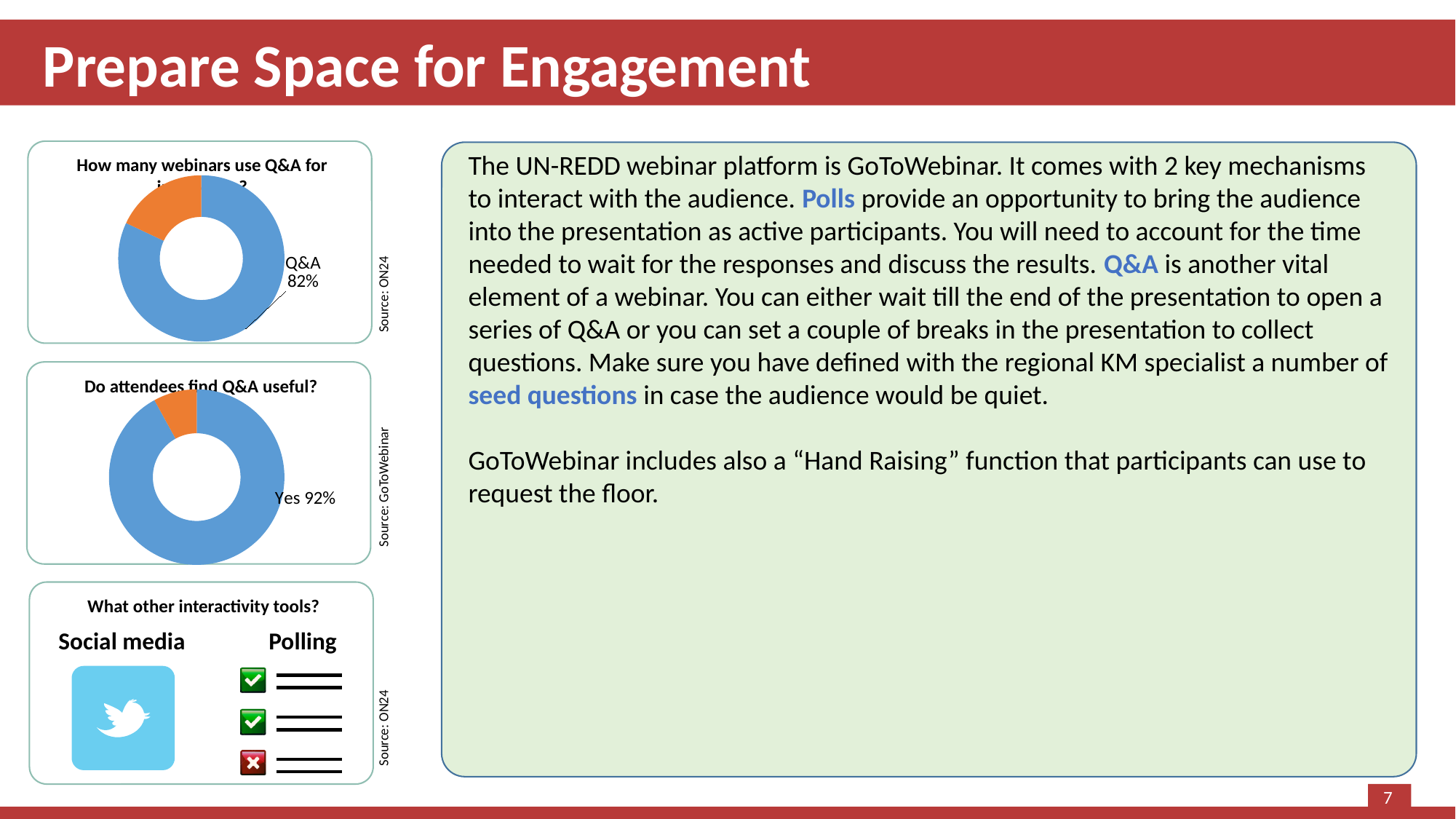
What kind of chart is the chart titled "Do attendees find Q&A useful?"? Doughnut chart In the top chart, which slice is larger, the blue slice or the orange slice? The blue slice What source is cited beside the chart titled "Do attendees find Q&A useful?"? GoToWebinar In the chart titled "Do attendees find Q&A useful?", which slice is smaller, the blue slice or the orange slice? The orange slice What kind of chart is the top chart on the left of the slide? Doughnut chart What colour is the Yes slice in the chart titled "Do attendees find Q&A useful?"? Blue In the top chart, what percentage is shown for the Q&A slice? 82% How many slices does the chart titled "Do attendees find Q&A useful?" have? 2 What is the difference between the Yes share (92%) in the middle chart and the Q&A share (82%) in the top chart? 10 percentage points In the chart titled "Do attendees find Q&A useful?", what percentage is shown for the Yes slice? 92% Which is larger: the Q&A share in the top chart or the Yes share in the chart titled "Do attendees find Q&A useful?"? The Yes share (92%) How many slices does the top doughnut chart have? 2